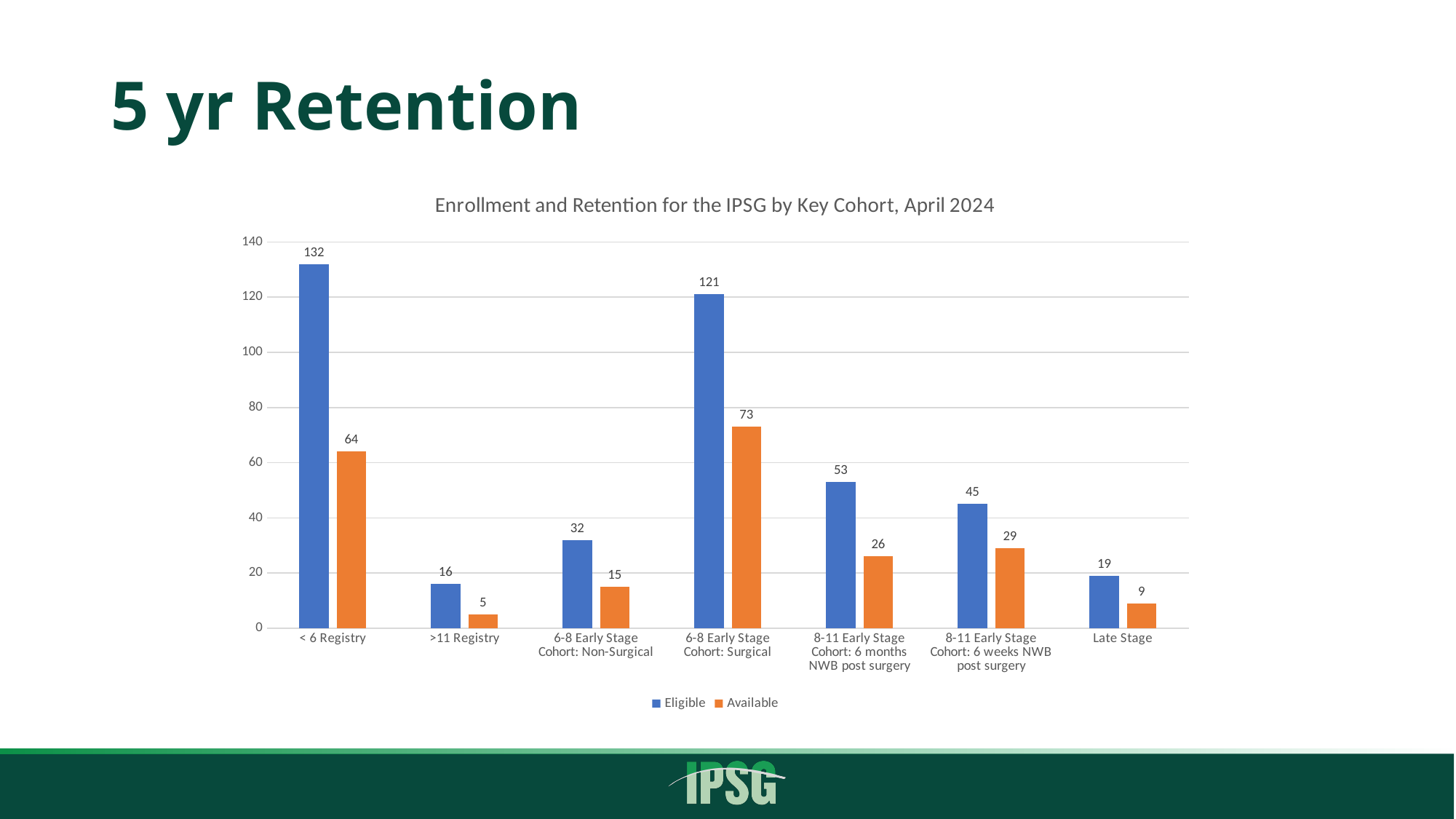
What is the Available value for the >11 Registry cohort? 5 Which cohort has the highest Eligible value? < 6 Registry How many series does the legend list? 2 What is the Eligible value for the Late Stage cohort? 19 What is the title of the chart? Enrollment and Retention for the IPSG by Key Cohort, April 2024 How many cohorts are shown on the x axis? 7 What kind of chart is shown on the slide? Bar chart What is the Available value for the 6-8 Early Stage Cohort: Surgical? 73 What is the Eligible value for the < 6 Registry cohort? 132 What is the difference between the Eligible and Available values for the 6-8 Early Stage Cohort: Surgical? 48 Which is larger: the Available value for 8-11 Early Stage Cohort: 6 months NWB post surgery or the Available value for 8-11 Early Stage Cohort: 6 weeks NWB post surgery? 8-11 Early Stage Cohort: 6 weeks NWB post surgery Which cohort has the lowest Available value? >11 Registry